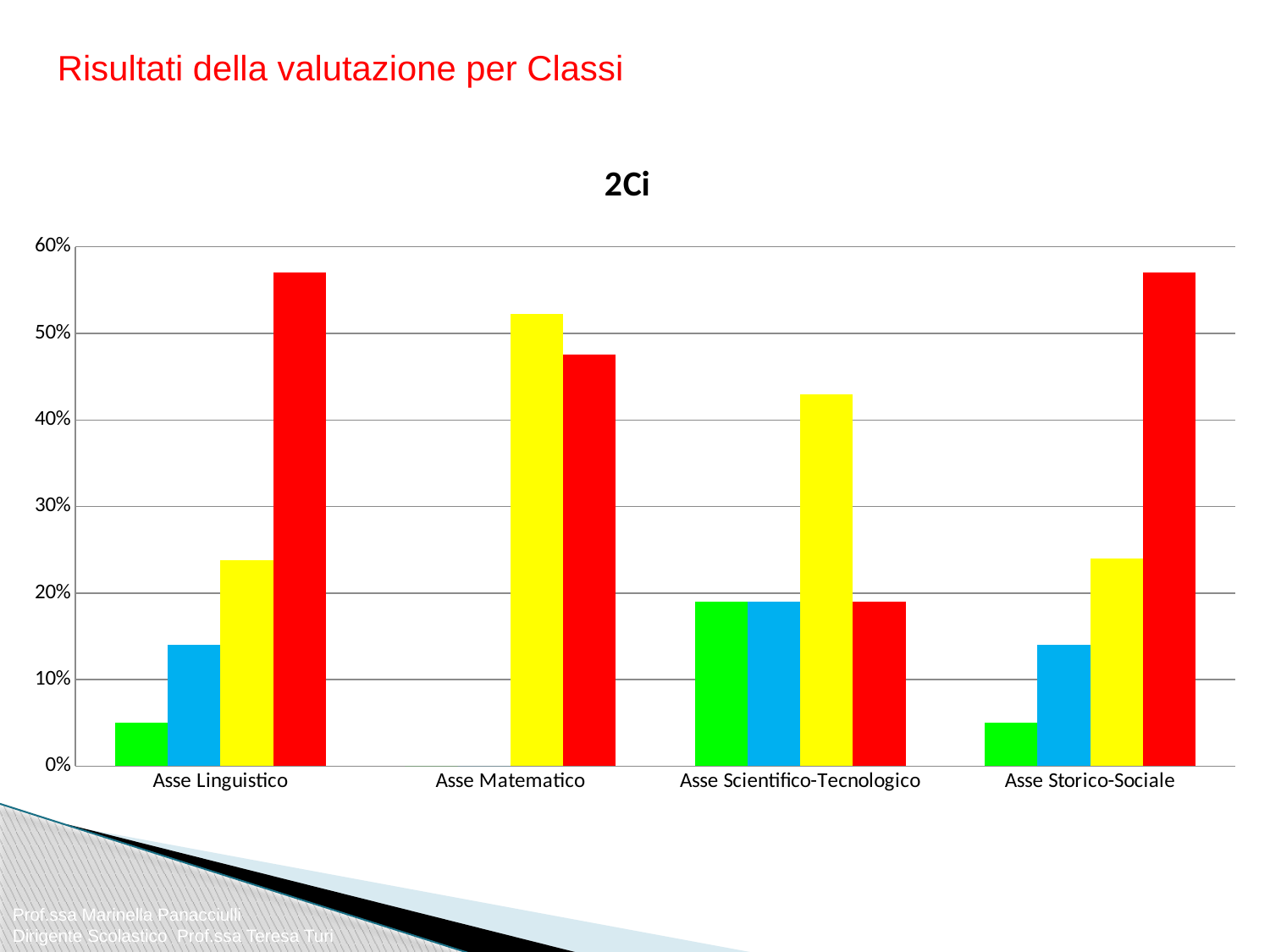
What kind of chart is shown on the slide? bar chart Which category has no green or blue bar? Asse Matematico Is the value of the red bar for Asse Matematico greater or less than 50%? less Which bar is the tallest in the Asse Scientifico-Tecnologico category? yellow Is the value of the yellow bar for Asse Scientifico-Tecnologico greater or less than 40%? greater Is the value of the red bar for Asse Linguistico greater or less than 50%? greater What is the title of the chart? 2Ci Which bar is the tallest in the Asse Matematico category, the yellow one or the red one? yellow Which bar is the shortest in the Asse Linguistico category? green How many categories are shown on the x axis of the chart? 4